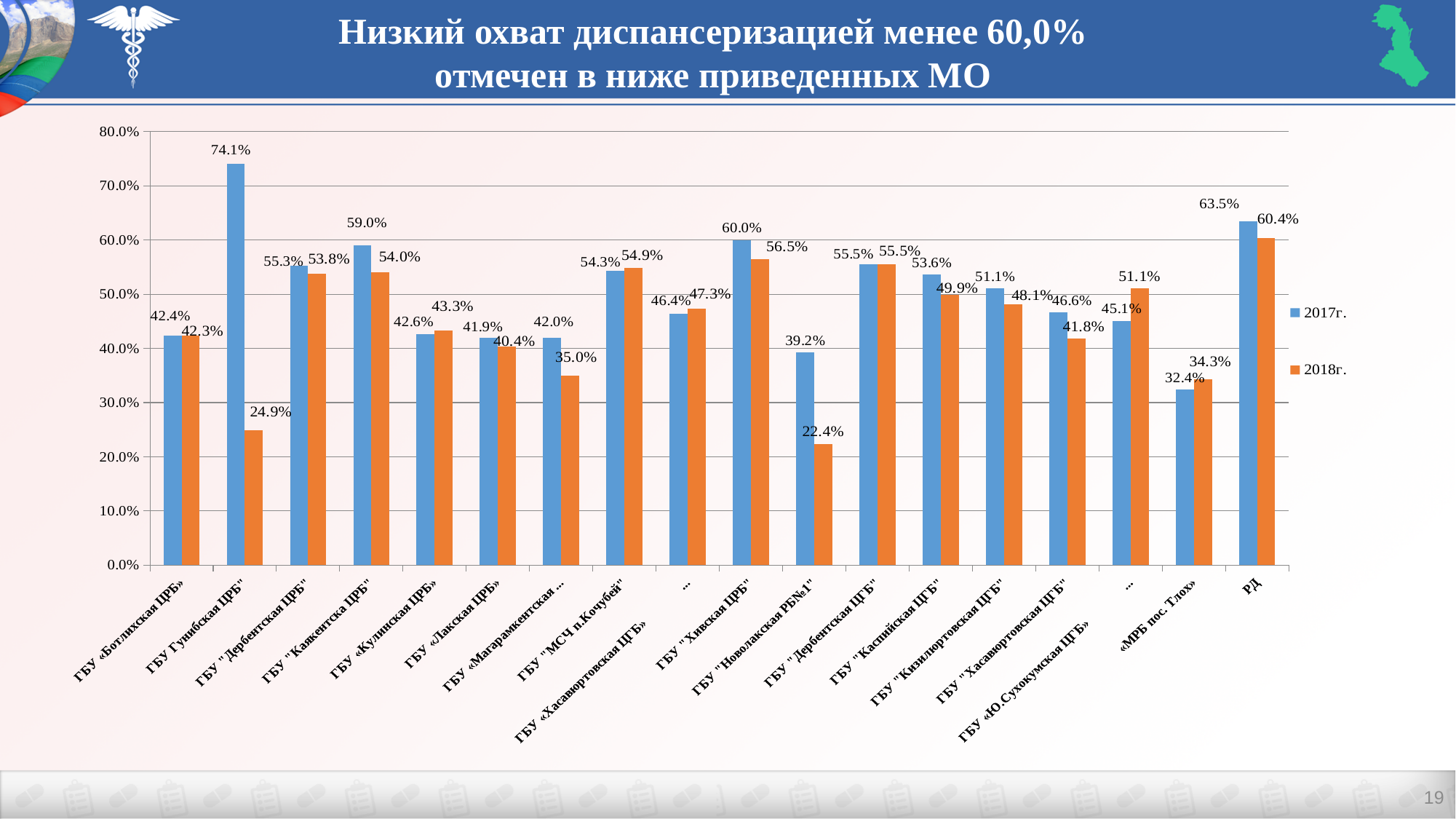
Which category has the highest 2017г. value? ГБУ Гунибская ЦРБ What is the 2017г. value for ГБУ Гунибская ЦРБ? 74.1% What are the two legend entries of the chart? 2017г. and 2018г. What is the 2017г. value for ГБУ "Хивская ЦРБ"? 60.0% How many series does the legend list? 2 Which category has the lowest 2017г. value? «МРБ пос. Тлох» What is the 2018г. value for РД? 60.4% What is the 2018г. value for ГБУ "Новолакская РБ№1"? 22.4% What is the difference between the 2017г. and 2018г. values for ГБУ Гунибская ЦРБ? 49.2% What type of chart is shown on the slide? bar chart Which category has the lowest 2018г. value? ГБУ "Новолакская РБ№1" Which is larger for ГБУ «Ю.Сухокумская ЦГБ»: the 2017г. value or the 2018г. value? 2018г.